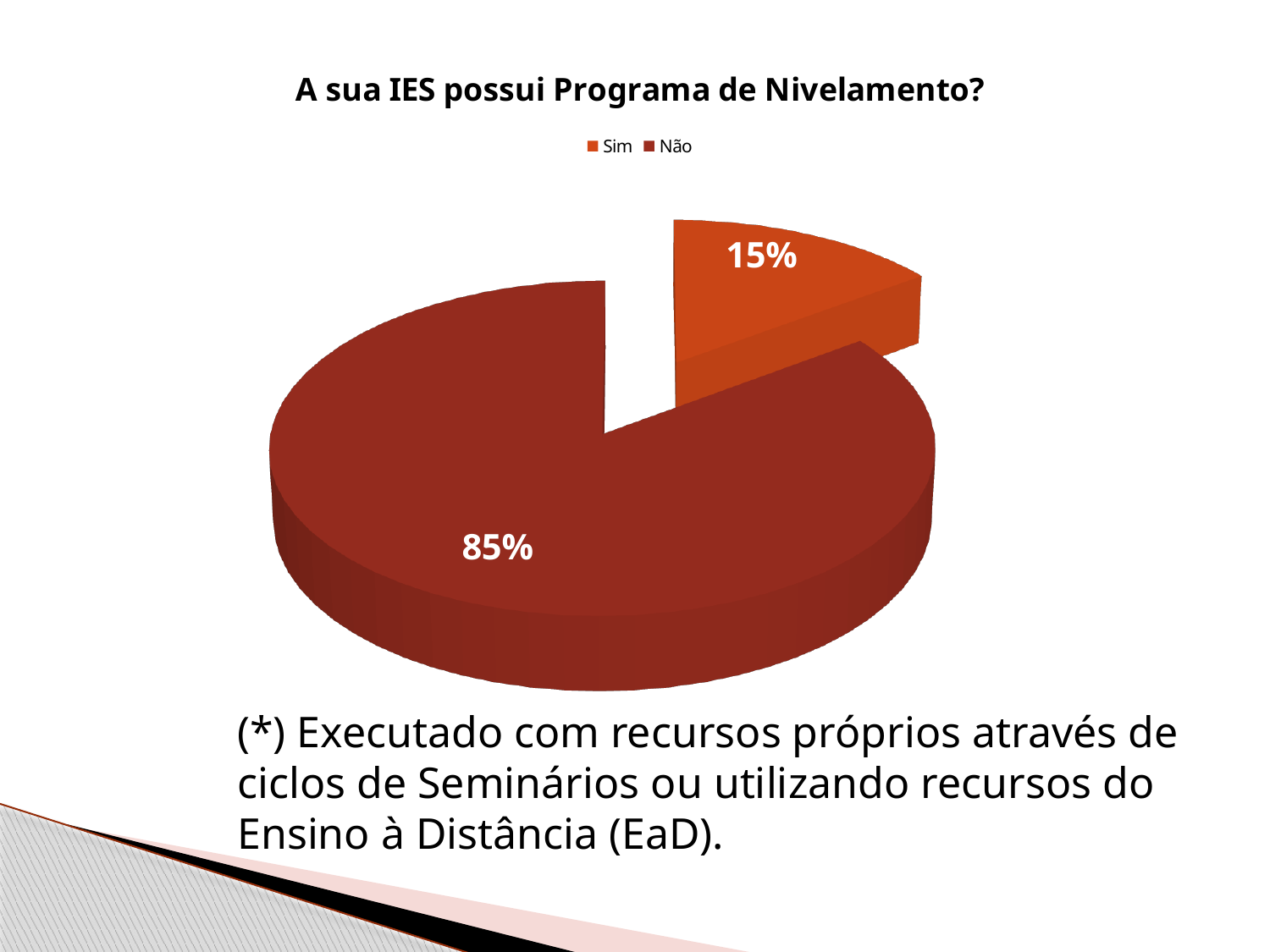
Which category has the smallest share of the pie? Sim How many slices does the pie chart have? 2 Which is larger, the share for "Sim" or the share for "Não"? Não What is the title of the chart? A sua IES possui Programa de Nivelamento? Which slice is pulled out (exploded) from the pie? Sim What percentage of the pie corresponds to "Sim"? 15% What share of the pie does the "Sim" slice represent? 15% What is the difference in percentage points between "Não" and "Sim"? 70 Which category has the largest share of the pie? Não What percentage of the pie corresponds to "Não"? 85% How many entries does the legend list? 2 What type of chart is shown on the slide? Pie chart